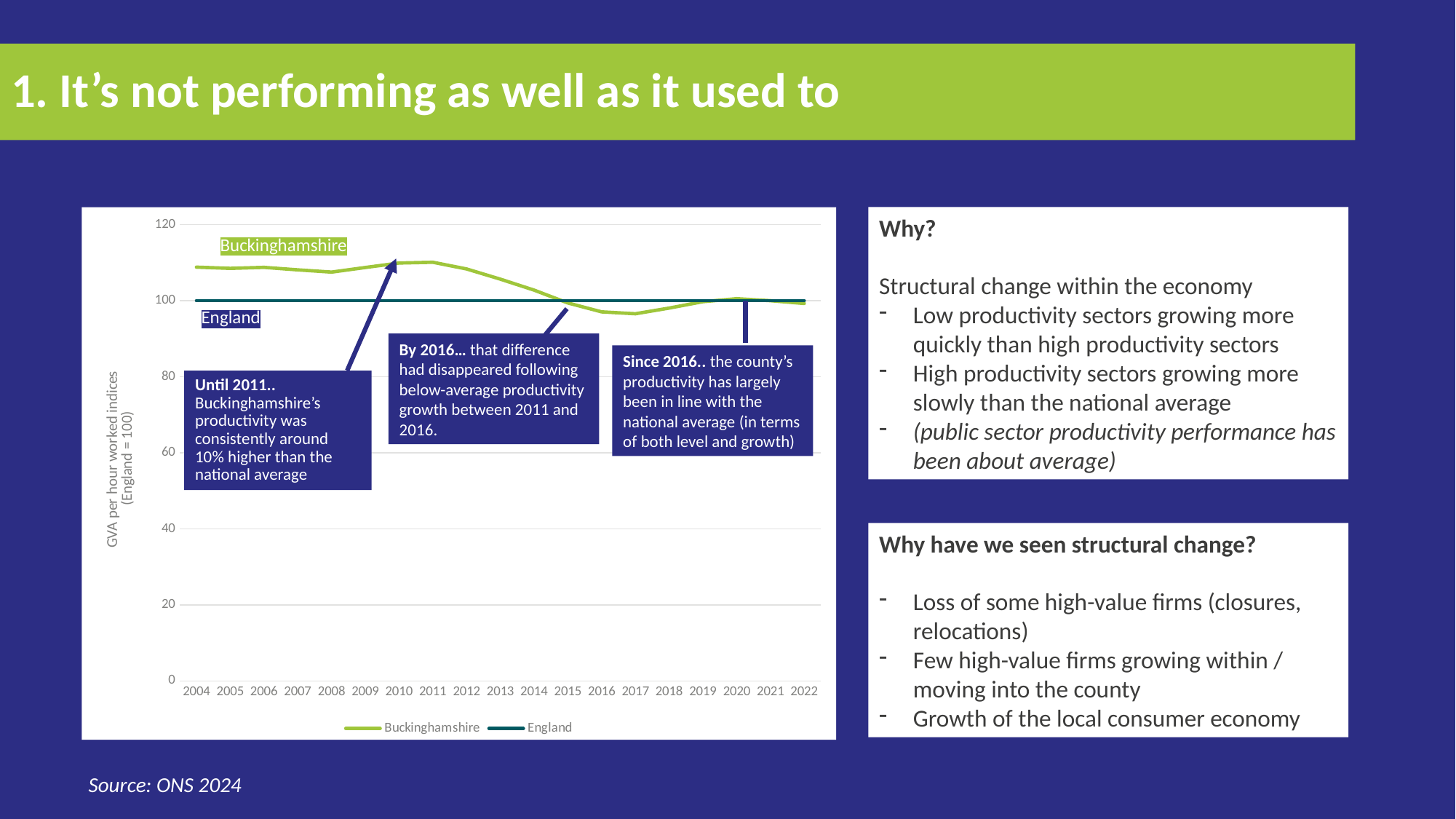
Is the value for Buckinghamshire in 2017 greater or less than 100? less How many years are shown along the x axis of the chart? 19 Is the value for Buckinghamshire in 2010 greater or less than 120? less What kind of chart is shown on the slide? Line chart In 2017, which series has the higher value, Buckinghamshire or England? England What is the y-axis title of the chart? GVA per hour worked indices (England = 100) In 2008, which series has the higher value, Buckinghamshire or England? Buckinghamshire How many series does the chart legend list? 2 Does the Buckinghamshire series rise or fall between 2011 and 2016? Fall Is the value for Buckinghamshire in 2004 greater or less than 100? greater What is the value of the England series in 2010? 100 Which series is drawn in light green on the chart? Buckinghamshire